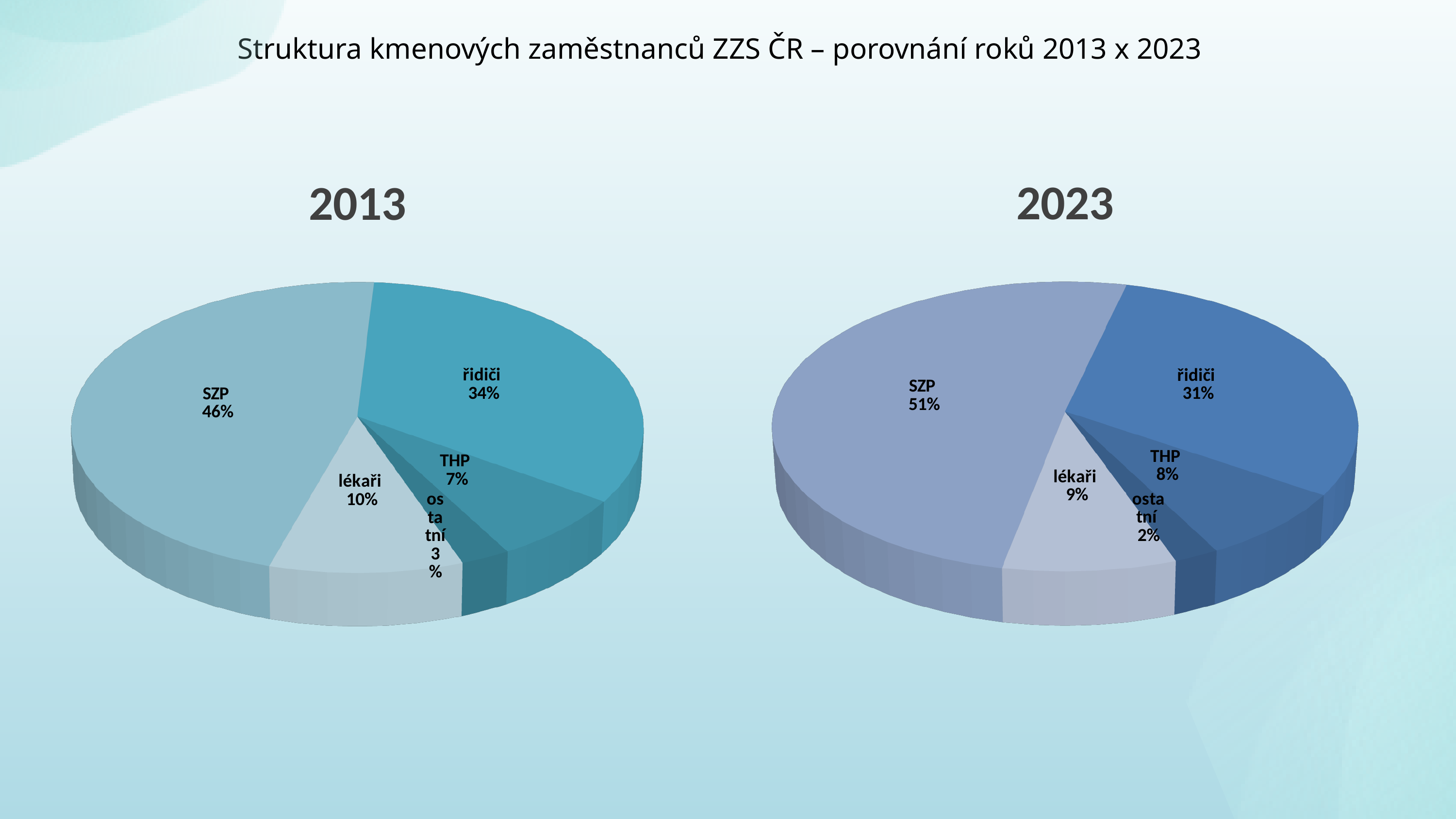
In the 2023 chart, which category has the largest share? SZP Which is larger: the řidiči share in 2013 or the řidiči share in 2023? 2013 In the 2013 chart, what share do SZP have? 46% In the 2013 chart, what share do lékaři have? 10% What kind of chart is used for the 2023 data? Pie chart In the 2023 chart, which category has the smallest share? ostatní What is the title of the slide? Struktura kmenových zaměstnanců ZZS ČR – porovnání roků 2013 x 2023 How many categories does the 2013 chart show? 5 In the 2023 chart, what share do řidiči have? 31% In the 2013 chart, which category has the smallest share? ostatní In the 2023 chart, what share do THP have? 8% What is the difference between the SZP share in 2023 and the SZP share in 2013? 5 percentage points